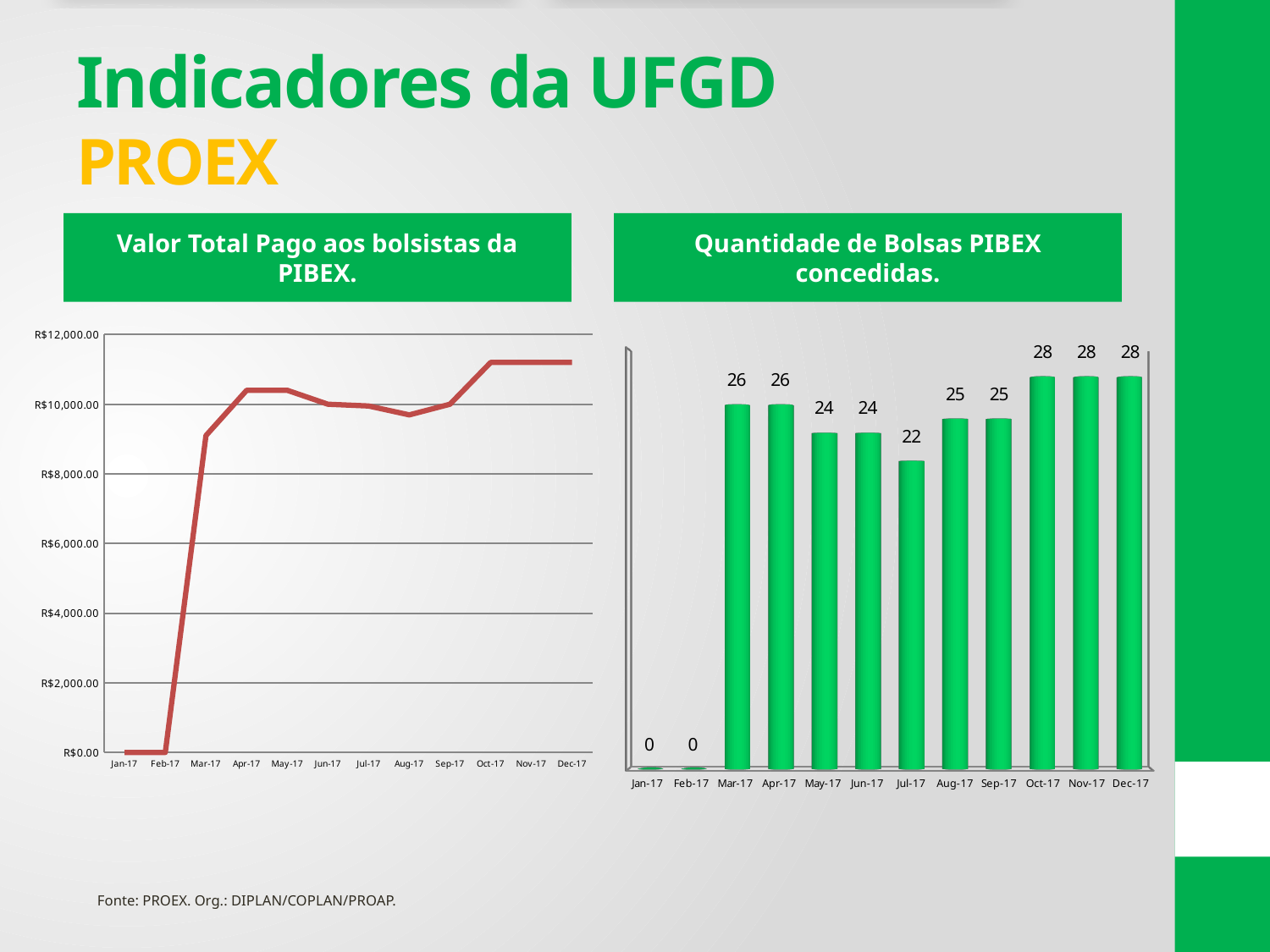
On the chart titled "Quantidade de Bolsas PIBEX concedidas.", what is the difference between the values for Dec-17 and Jul-17? 6 What kind of chart is the one titled "Valor Total Pago aos bolsistas da PIBEX."? line chart On the chart titled "Valor Total Pago aos bolsistas da PIBEX.", is the value for Oct-17 greater or less than R$10,000.00? greater On the chart titled "Quantidade de Bolsas PIBEX concedidas.", what is the value for Jul-17? 22 On the chart titled "Quantidade de Bolsas PIBEX concedidas.", which month from Mar-17 to Dec-17 has the lowest value? Jul-17 On the chart titled "Quantidade de Bolsas PIBEX concedidas.", what is the value for Mar-17? 26 On the chart titled "Quantidade de Bolsas PIBEX concedidas.", which is larger, the value for Mar-17 or the value for May-17? Mar-17 On the chart titled "Valor Total Pago aos bolsistas da PIBEX.", is the value for Mar-17 greater or less than R$8,000.00? greater On the chart titled "Quantidade de Bolsas PIBEX concedidas.", what is the value for Feb-17? 0 What kind of chart is the one titled "Quantidade de Bolsas PIBEX concedidas."? bar chart On the chart titled "Quantidade de Bolsas PIBEX concedidas.", what is the value for Dec-17? 28 On the chart titled "Quantidade de Bolsas PIBEX concedidas.", how many months are shown on the x axis? 12